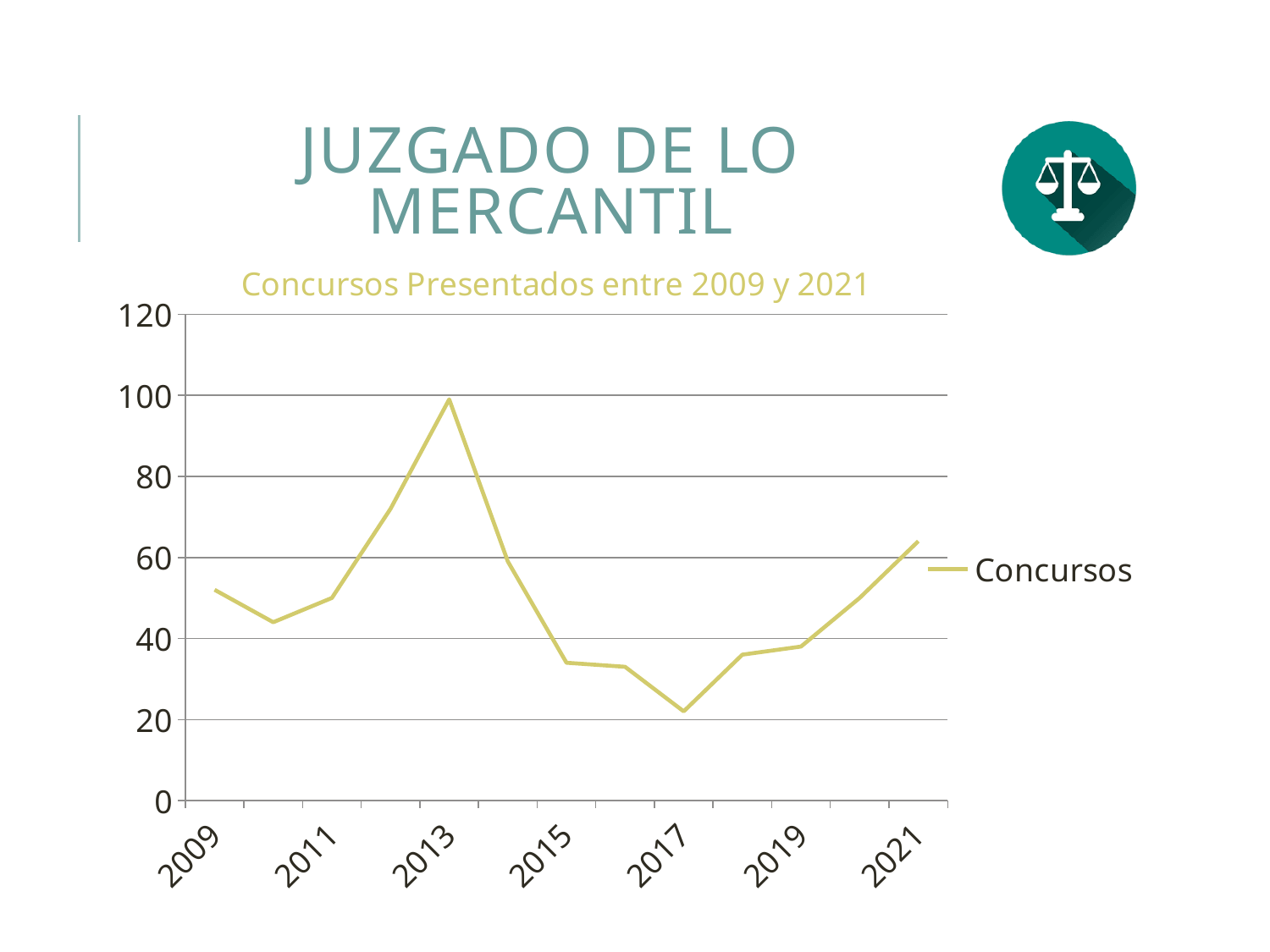
Is the value for 2013 greater or less than 80? greater Is the value for 2017 greater or less than 40? less Do the values rise or fall between 2013 and 2017? Fall What is the name of the series shown in the legend? Concursos What is the title of the chart? Concursos Presentados entre 2009 y 2021 Is the value for 2009 greater or less than 40? greater Which year has a higher value, 2009 or 2015? 2009 What kind of chart is shown on the slide? Line chart Do the values rise or fall between 2017 and 2021? Rise How many series does the legend list? 1 In which year is the number of Concursos highest? 2013 In which year is the number of Concursos lowest? 2017